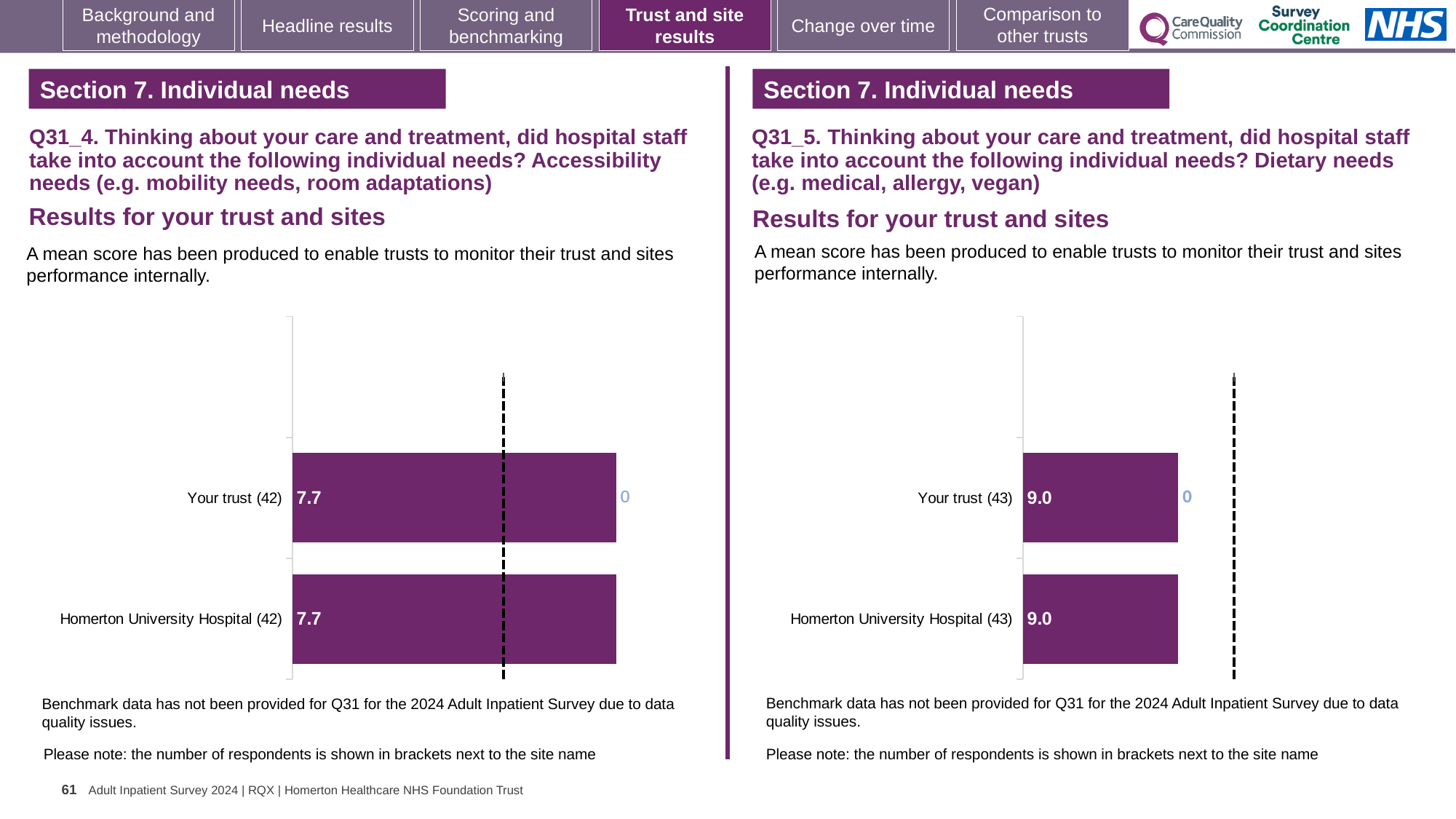
In the left chart (Q31_4, Accessibility needs), what is the value for Homerton University Hospital? 7.7 How many bars are plotted in the left chart (Q31_4, Accessibility needs)? 2 In the left chart (Q31_4, Accessibility needs), what is the value for Your trust? 7.7 In the left chart (Q31_4, Accessibility needs), what is the difference between the value for Your trust and the value for Homerton University Hospital? 0.0 Is the value for Your trust in the left chart (Q31_4) or the value for Your trust in the right chart (Q31_5) larger? Your trust in the right chart (Q31_5), 9.0 In the right chart (Q31_5, Dietary needs), what is the value for Homerton University Hospital? 9.0 In the left chart (Q31_4, Accessibility needs), how many respondents are shown in brackets next to Your trust? 42 How many bars are plotted in the right chart (Q31_5, Dietary needs)? 2 In the right chart (Q31_5, Dietary needs), how many respondents are shown in brackets next to Homerton University Hospital? 43 In the right chart (Q31_5, Dietary needs), what is the difference between the value for Your trust and the value for Homerton University Hospital? 0.0 What kind of chart is used in the left chart (Q31_4, Accessibility needs)? Bar chart In the right chart (Q31_5, Dietary needs), what is the value for Your trust? 9.0